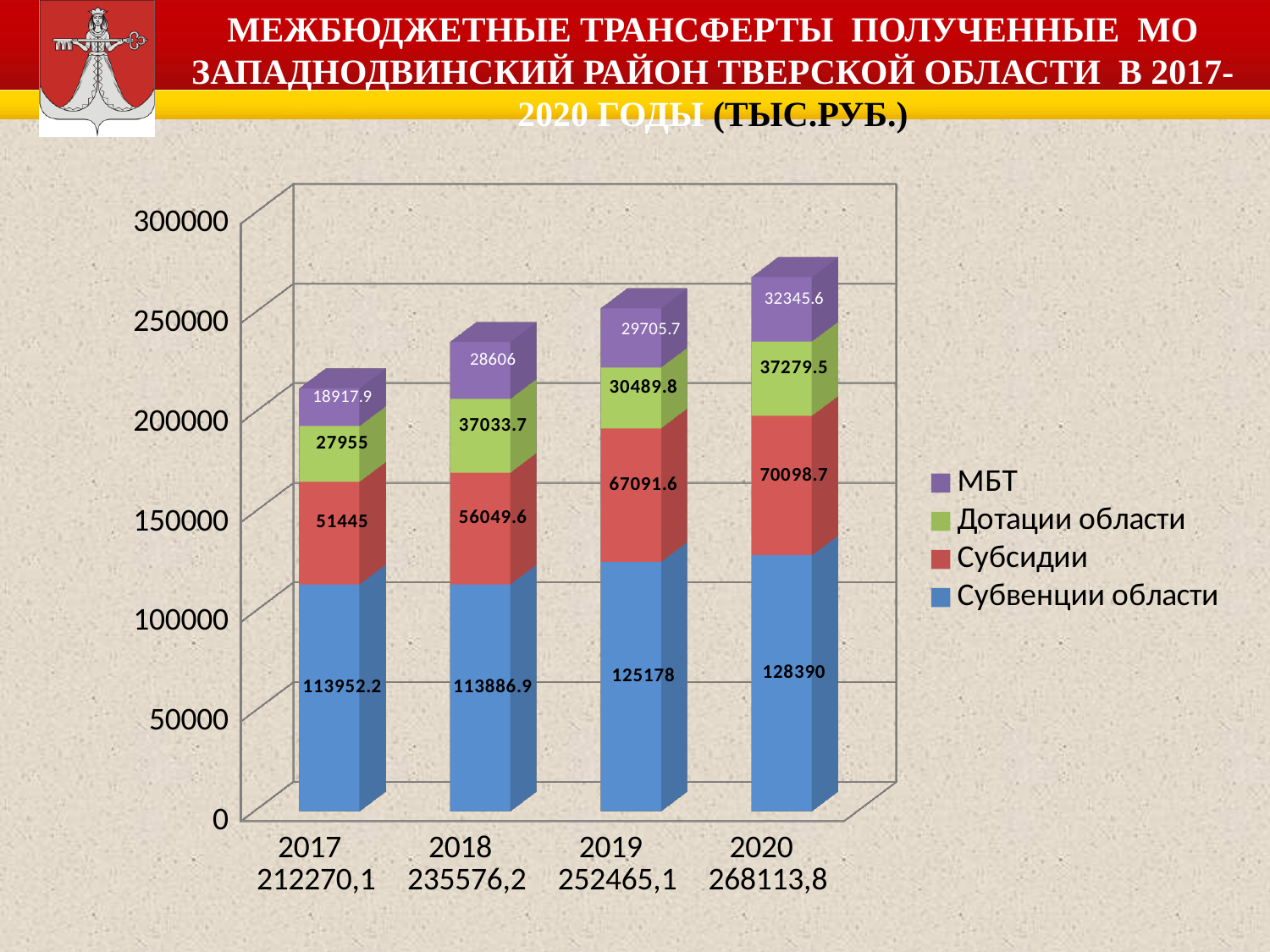
What is the value of Субвенции области for 2017? 113952.2 What kind of chart is shown on the slide? Stacked bar chart How many series does the legend list? 4 What is the difference between the Субвенции области values for 2020 and 2019? 3212 What is the value of МБТ for 2020? 32345.6 Which year has the larger Дотации области value, 2018 or 2019? 2018 In which year is the МБТ value the lowest? 2017 What is the value of Дотации области for 2018? 37033.7 How many years are shown on the x axis? 4 What is the total of the stacked bar for 2020? 268113,8 In which year is the Субсидии value the highest? 2020 What is the value of Субсидии for 2019? 67091.6